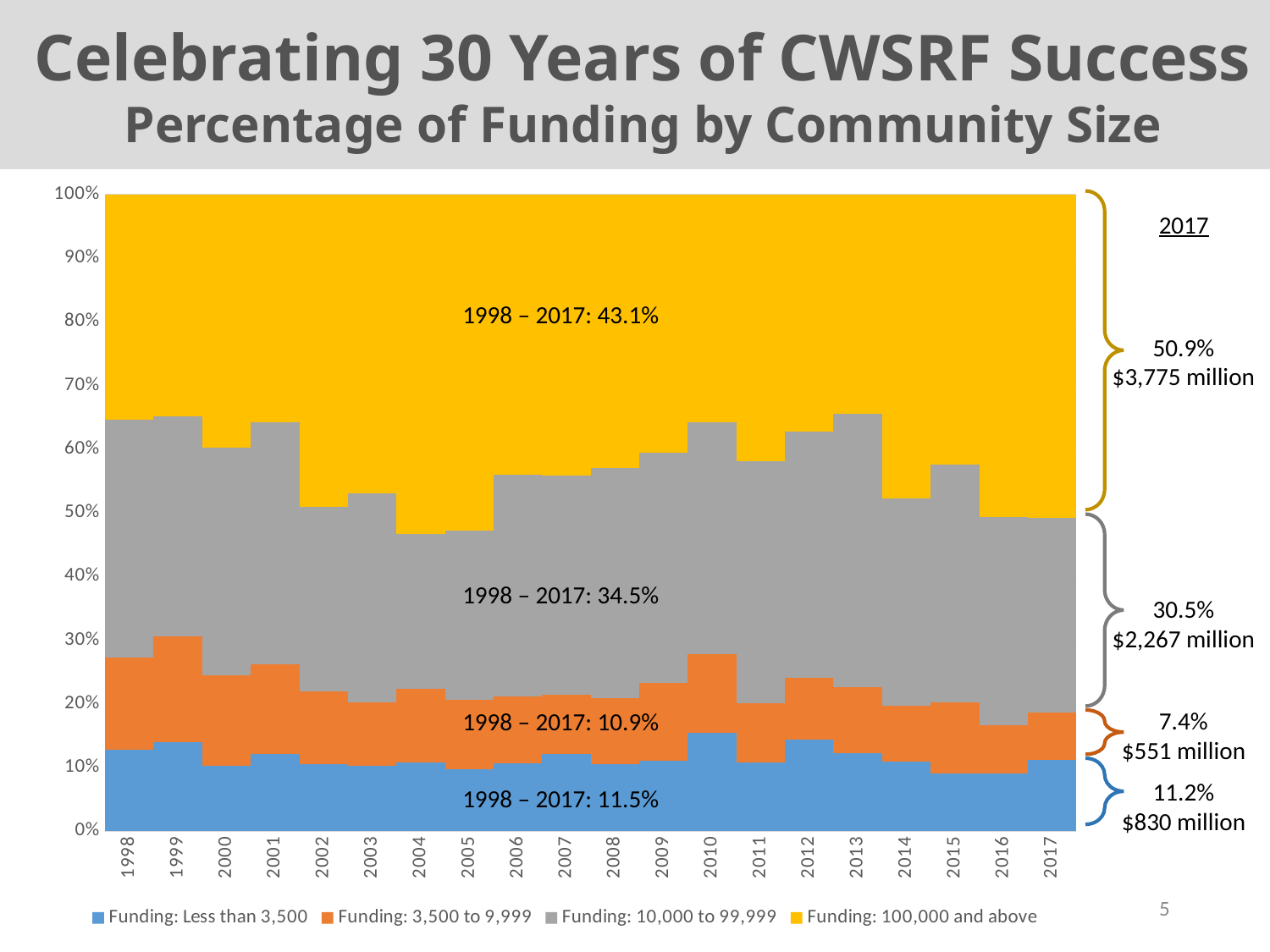
What is the 1998 – 2017 percentage of funding for communities of 10,000 to 99,999? 34.5% What is the total 2017 funding across all four community size categories, based on the dollar amounts shown? $7,423 million What is the difference between the 1998 – 2017 shares for communities of 100,000 and above and communities of 10,000 to 99,999? 8.6 percentage points Which community size category received the smallest share of funding over 1998 – 2017? Funding: 3,500 to 9,999 What percentage of funding went to communities of 100,000 and above in 2017? 50.9% Which community size category received the largest share of funding over 1998 – 2017? Funding: 100,000 and above How many years are shown on the x axis? 20 What dollar amount of funding went to communities of less than 3,500 in 2017? $830 million What kind of chart is shown on the slide? 100% stacked bar chart In 2017, which received a larger share of funding: communities of less than 3,500 or communities of 3,500 to 9,999? Less than 3,500 What is the 1998 – 2017 percentage of funding for communities of 100,000 and above? 43.1% How many series does the legend list? 4